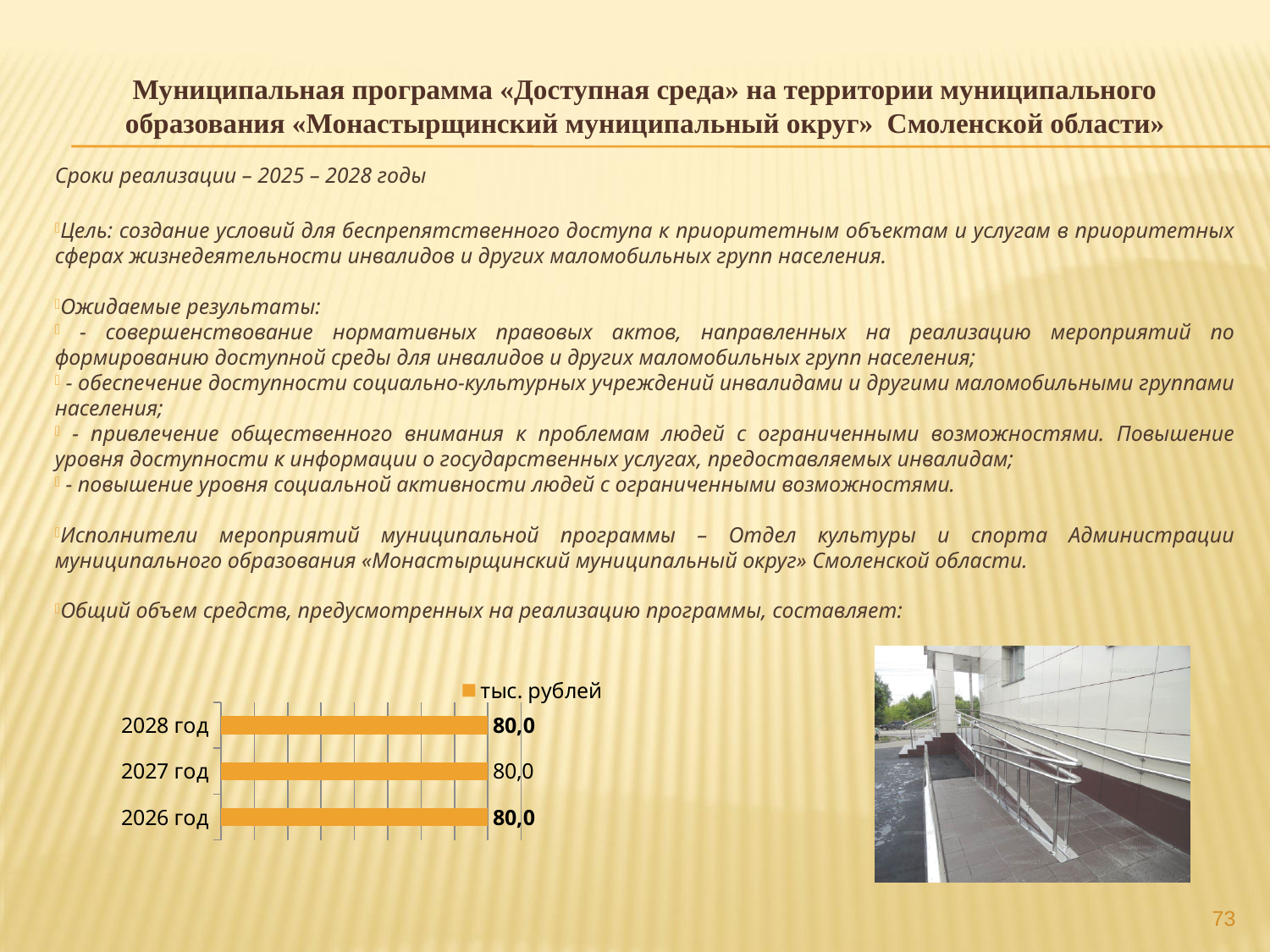
What is the name of the series shown in the chart legend? тыс. рублей How many categories (years) are plotted in the chart? 3 What is the value for 2027 год in the chart? 80,0 What type of chart is shown on the slide? bar chart What is the value for 2028 год in the chart? 80,0 What is the difference between the values for 2028 год and 2026 год? 0,0 Do the values rise, fall or stay the same from 2026 год to 2028 год? stay the same How many series does the chart legend list? 1 What is the value for 2026 год in the chart? 80,0 Which year is listed at the top of the chart's category axis? 2028 год What colour are the bars in the chart? orange